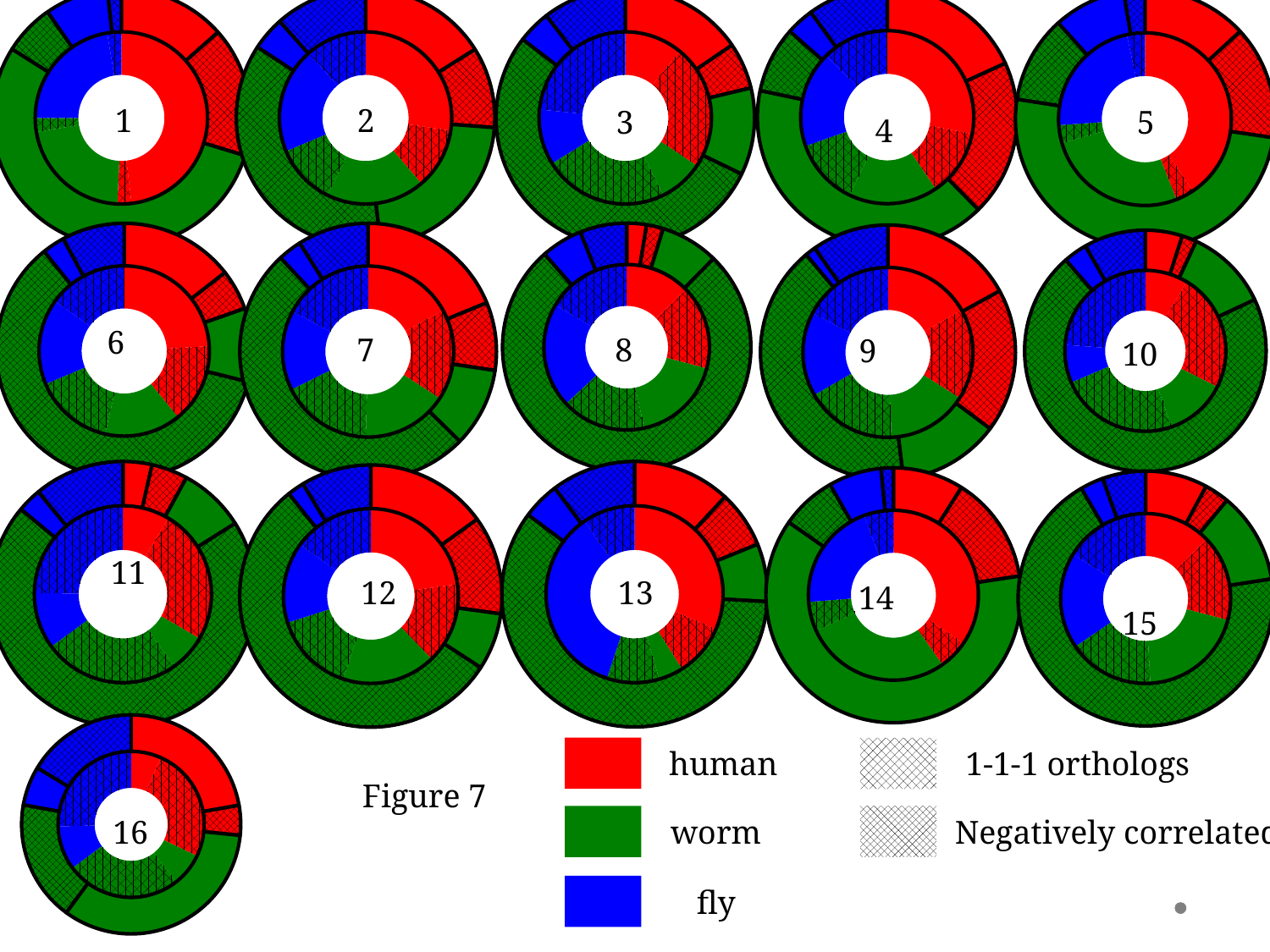
Which colour represents worm in the legend? green In chart 13, which species takes the largest share of the outer ring? worm In chart 14, which species has the largest share of the inner ring? human In chart 6, which species takes the largest share of the outer ring? worm How many numbered donut charts are shown on the slide? 16 How many species does the legend list by colour? 3 In chart 10, which has the larger share of the outer ring: worm or human? worm What figure number is given in the caption on the slide? Figure 7 In chart 1, which has the larger share of the inner ring: human or fly? human In chart 5, which has the larger share of the inner ring: human or worm? human What kind of chart is used for each of the numbered panels on the slide? donut (nested pie) chart In chart 8, which species has the smallest share of the outer ring? human